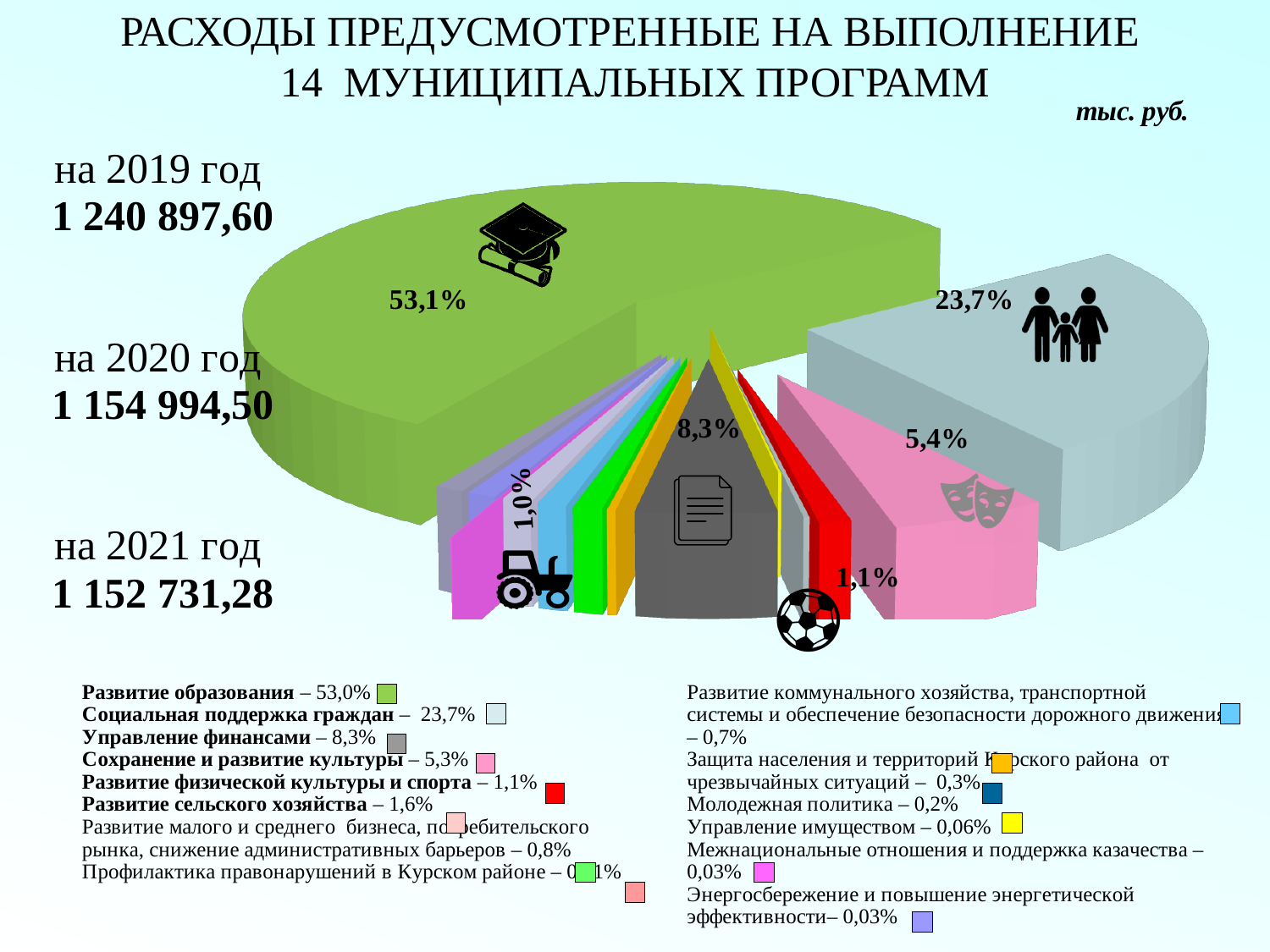
What percentage is printed on the largest slice of the pie chart? 53,1% Which program has the largest slice of the pie chart? Развитие образования According to the legend, what share is listed for Управление имуществом? 0,06% What total expenditure is shown for 2019 (на 2019 год)? 1 240 897,60 What percentage is shown on the pie chart for Сохранение и развитие культуры? 5,4% What unit of measurement is indicated for the expenditure figures on the slide? тыс. руб. What is the difference in percentage points between the largest slice (53,1%) and the second largest slice (23,7%)? 29,4 How many municipal programs does the chart cover, according to the title? 14 Which slice is larger: Сохранение и развитие культуры or Развитие физической культуры и спорта? Сохранение и развитие культуры What percentage is shown on the pie chart for Управление финансами? 8,3% What percentage is shown on the pie chart for Социальная поддержка граждан? 23,7% What type of chart is shown on the slide? pie chart